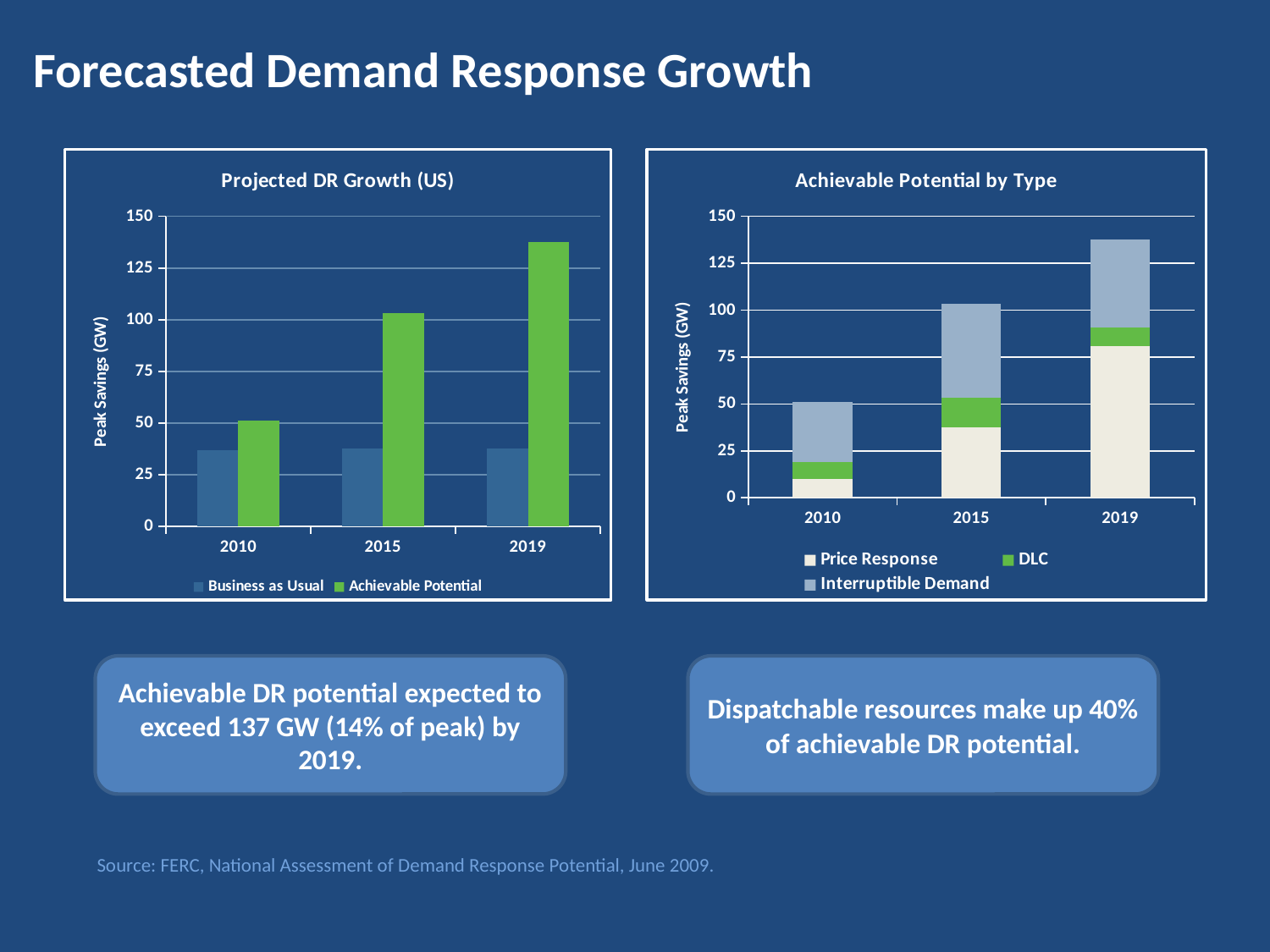
In the 'Achievable Potential by Type' chart, is the Price Response value for 2019 greater or less than 50? greater In the 'Projected DR Growth (US)' chart, how many series does the legend list? 2 In the 'Projected DR Growth (US)' chart, how many years are shown on the x axis? 3 In the 'Projected DR Growth (US)' chart, for 2015, which is larger: Business as Usual or Achievable Potential? Achievable Potential In the 'Projected DR Growth (US)' chart, which year has the highest Achievable Potential value? 2019 In the 'Projected DR Growth (US)' chart, what kind of chart is shown? bar chart In the 'Projected DR Growth (US)' chart, does the Achievable Potential series rise or fall from 2010 to 2019? rise In the 'Achievable Potential by Type' chart, which series is at the bottom of each stacked bar? Price Response In the 'Achievable Potential by Type' chart, how many series does the legend list? 3 In the 'Achievable Potential by Type' chart, which year has the tallest stacked bar? 2019 In the 'Projected DR Growth (US)' chart, is the Achievable Potential value for 2010 greater or less than 75? less In the 'Projected DR Growth (US)' chart, is the Achievable Potential value for 2019 greater or less than 125? greater